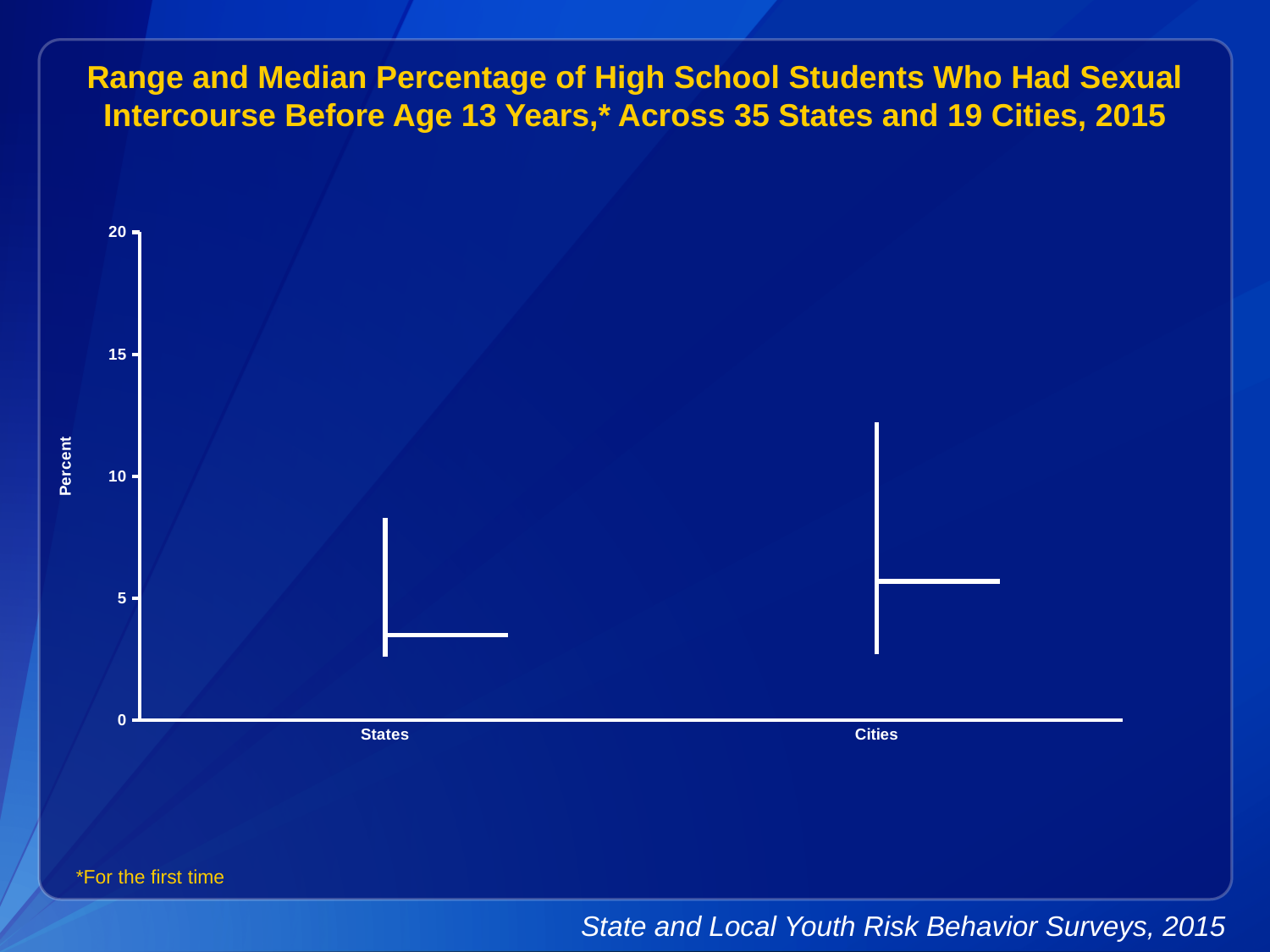
Which category has the higher maximum value in its range, States or Cities? Cities What is the highest value shown on the y axis? 20 Is the top of the range for Cities greater or less than 10? greater Is the top of the range for Cities greater or less than 15? less Is the median value for Cities greater or less than 5? greater How many categories are shown on the x axis of the chart? 2 What is the label on the y axis of the chart? Percent What are the two categories shown on the x axis? States and Cities Which category has the higher median percentage, States or Cities? Cities